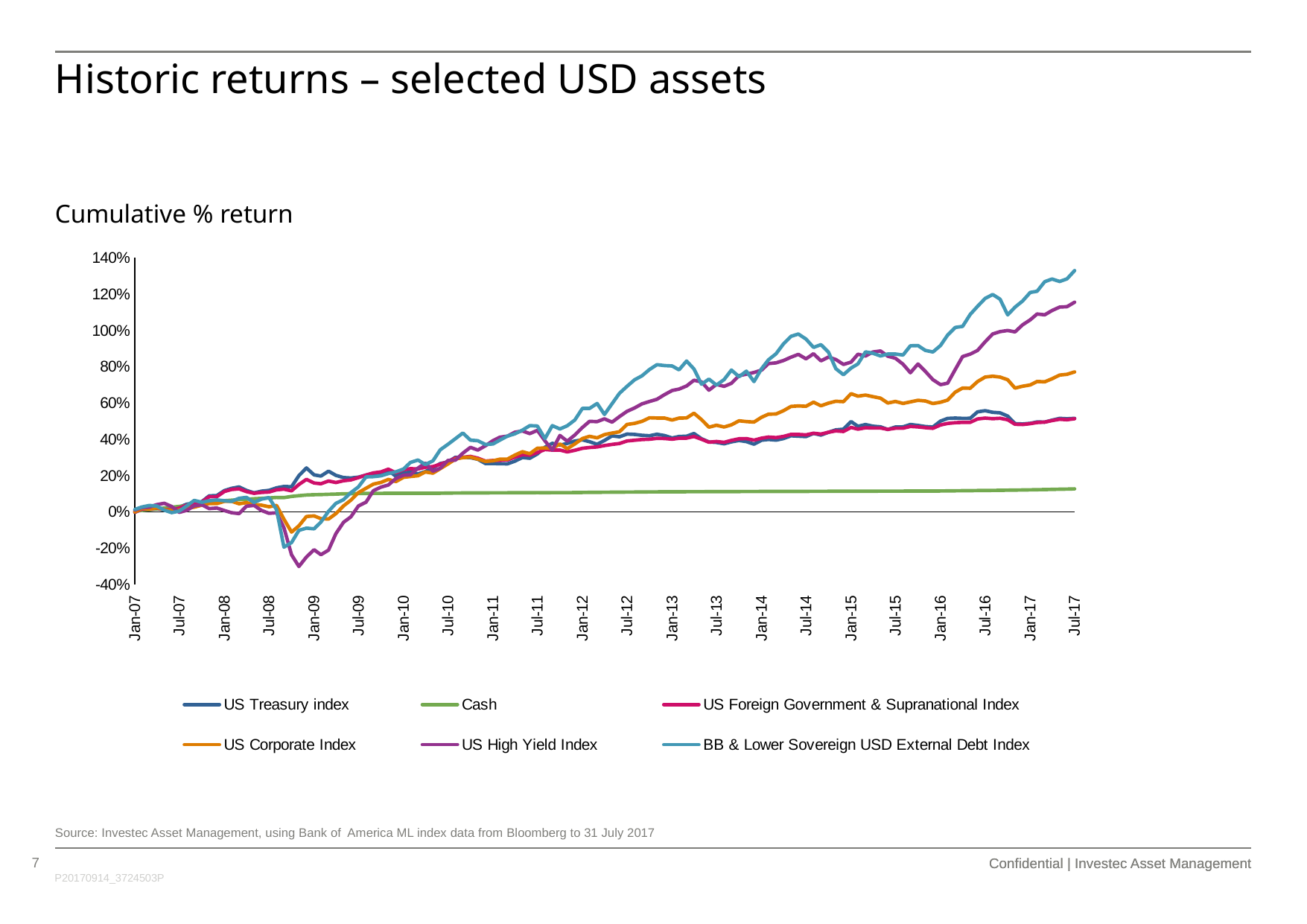
At Jul-17, which is higher: US Corporate Index or US Treasury index? US Corporate Index How many series does the legend list? 6 Which series has the lowest cumulative return at Jul-17? Cash What is the title shown above the chart? Cumulative % return What kind of chart is shown on the slide? line chart Is the value for Cash at Jul-17 greater or less than 20%? less Is the value for US Corporate Index at Jul-17 greater or less than 60%? greater Which series falls to the lowest point around early 2009? US High Yield Index Which series has the highest cumulative return at Jul-17? BB & Lower Sovereign USD External Debt Index Is the value for BB & Lower Sovereign USD External Debt Index at Jul-17 greater or less than 120%? greater Does the Cash series rise or fall from Jan-07 to Jul-17? rise